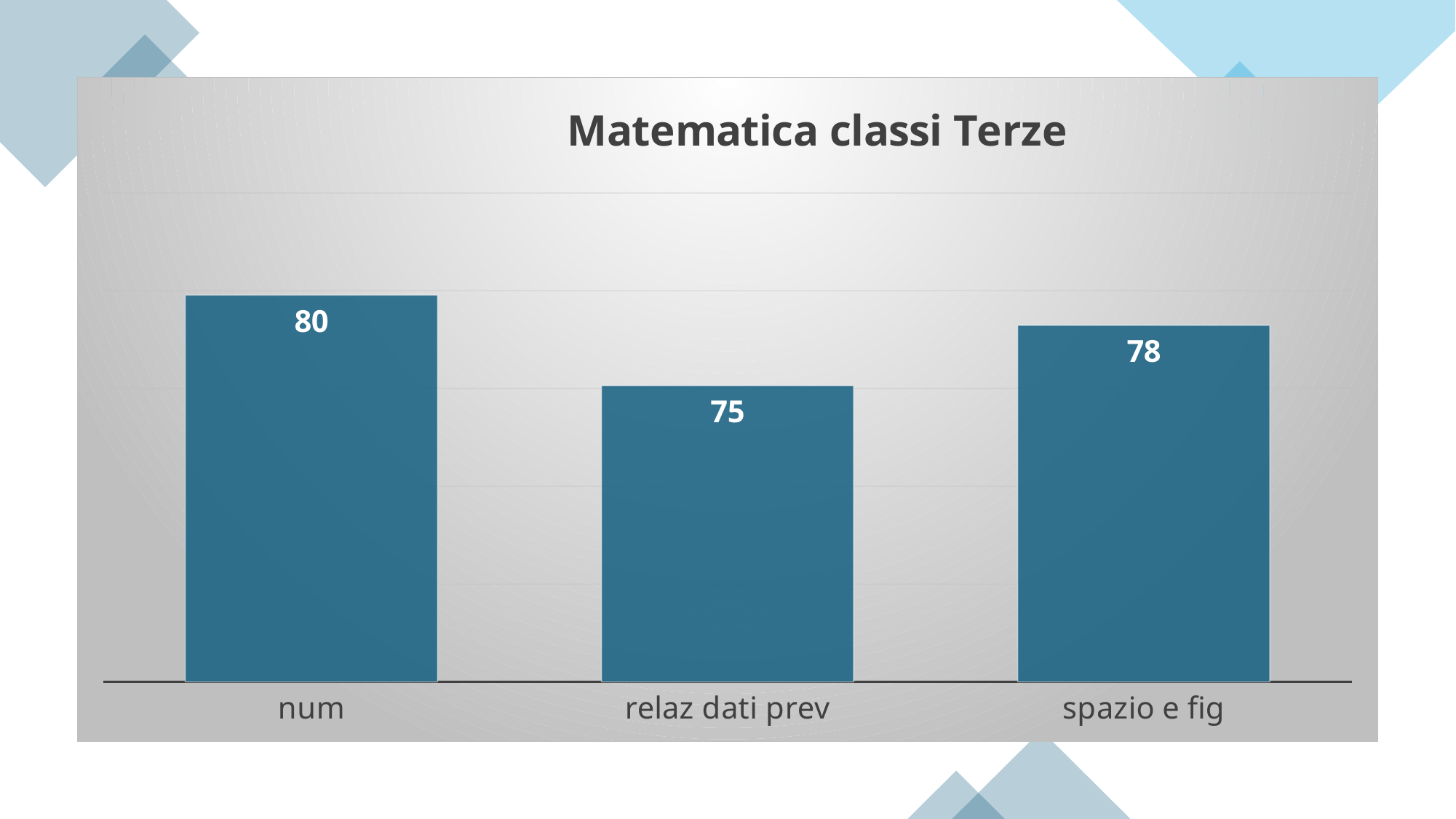
What is the difference between the values for spazio e fig and relaz dati prev? 3 Which category has the highest value? num What is the total of the three values shown in the chart? 233 What is the value for relaz dati prev? 75 What kind of chart is shown on the slide? bar chart Which category has the lowest value? relaz dati prev What is the value for num? 80 What is the difference between the values for num and relaz dati prev? 5 What is the value for spazio e fig? 78 What is the title of the chart? Matematica classi Terze Which is larger, the value for num or the value for spazio e fig? num How many categories are shown in the chart? 3